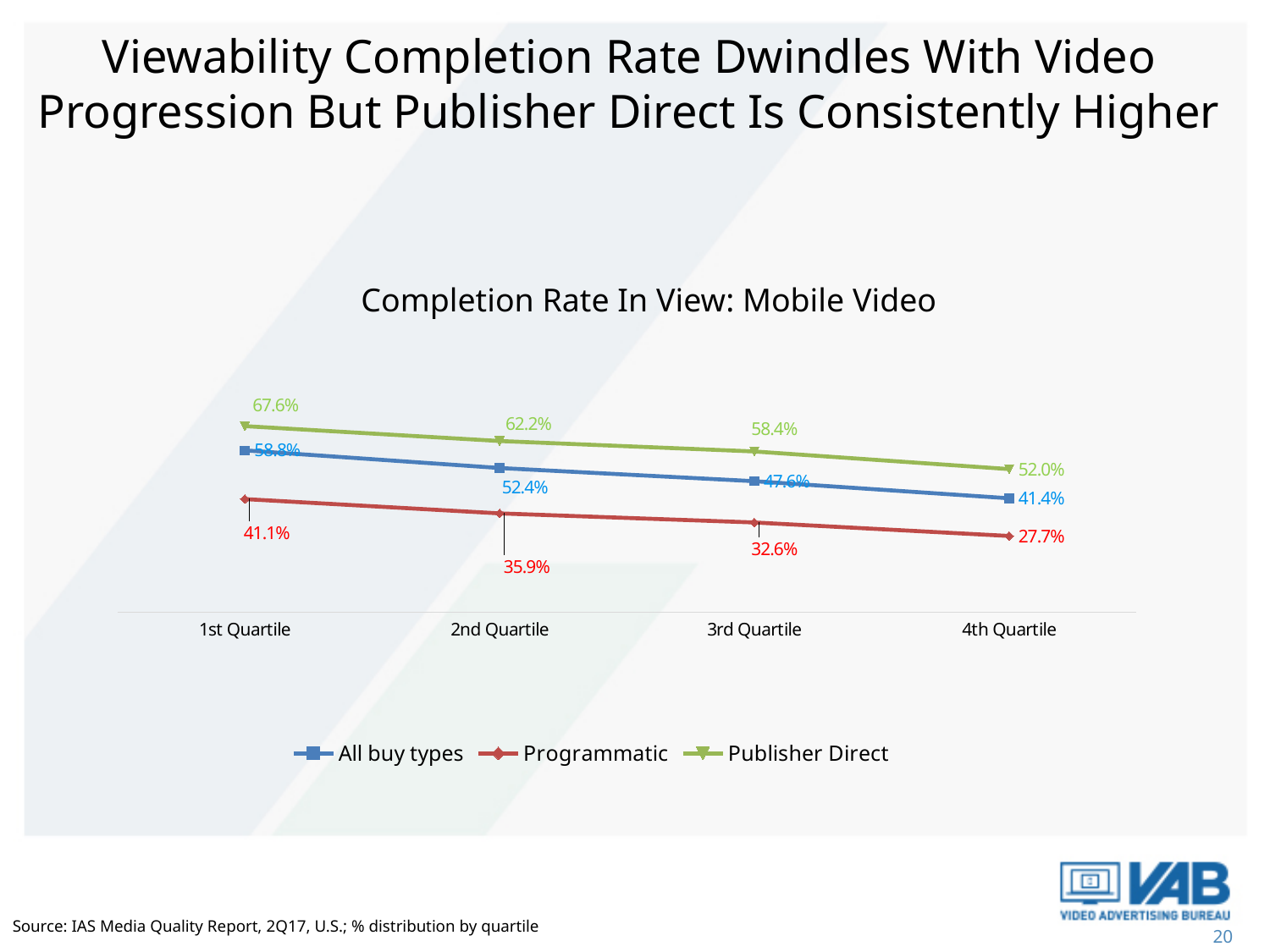
What kind of chart is shown on the slide? Line chart Do the Programmatic completion rates rise or fall from the 1st Quartile to the 4th Quartile? Fall How many quartiles are shown on the x axis? 4 What is the Publisher Direct completion rate at the 1st Quartile? 67.6% What is the difference between the Publisher Direct and Programmatic completion rates at the 2nd Quartile? 26.3% Which series has the lowest completion rate at the 1st Quartile? Programmatic Which series has the highest completion rate at the 4th Quartile? Publisher Direct What is the Publisher Direct completion rate at the 3rd Quartile? 58.4% What is the Programmatic completion rate at the 4th Quartile? 27.7% What is the title of the chart? Completion Rate In View: Mobile Video What is the All buy types completion rate at the 2nd Quartile? 52.4% How many series does the legend list? 3